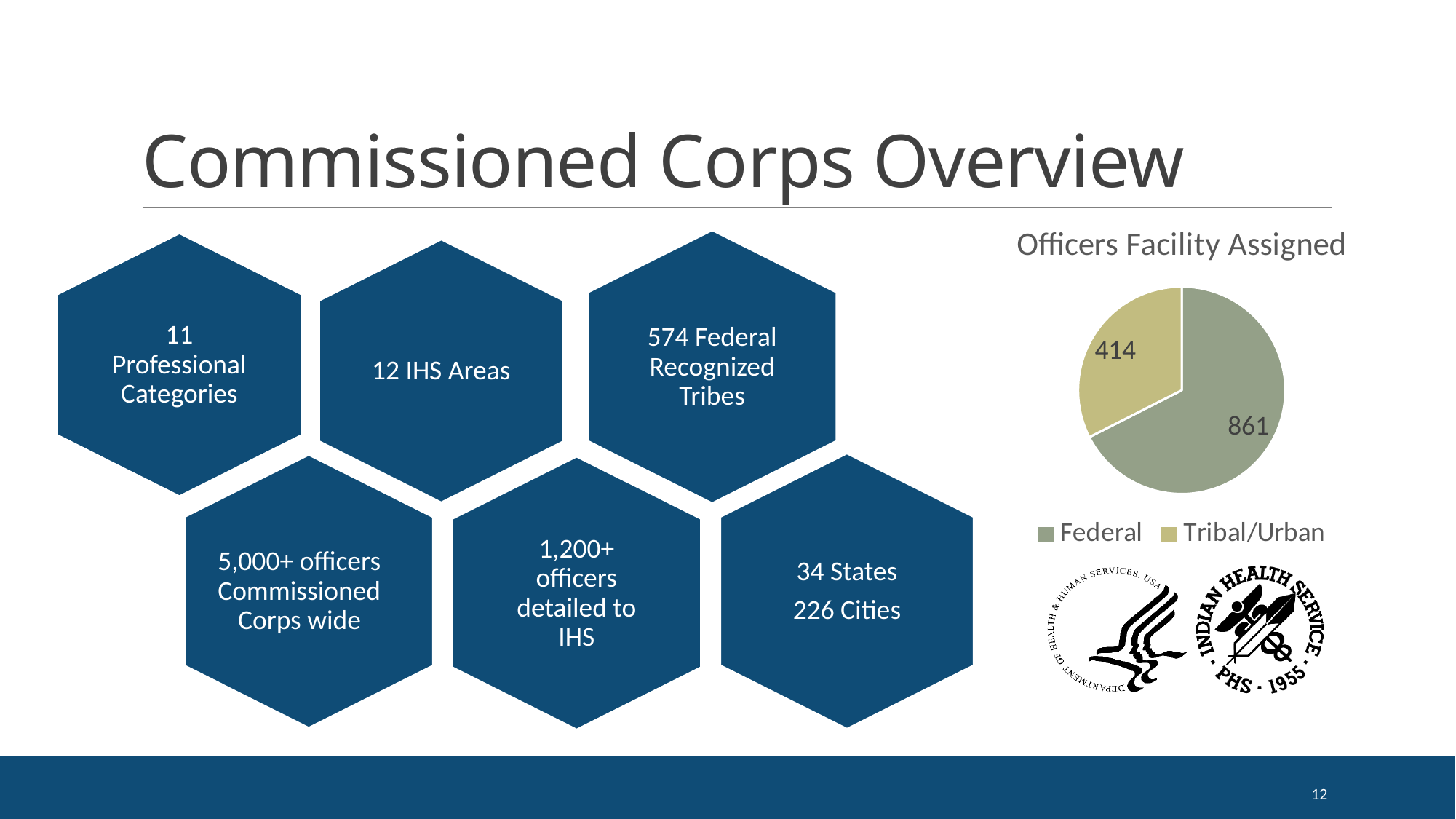
What is the title of the pie chart on the slide? Officers Facility Assigned In the Officers Facility Assigned chart, how many officers are assigned to Federal facilities? 861 In the Officers Facility Assigned chart, what is the difference between the Federal and Tribal/Urban values? 447 What kind of chart is shown under the title "Officers Facility Assigned"? pie chart What is the total of the two values shown in the Officers Facility Assigned pie chart? 1275 Which slice of the Officers Facility Assigned pie chart is the largest? Federal Which slice of the Officers Facility Assigned pie chart is the smallest? Tribal/Urban In the Officers Facility Assigned chart, is the Federal value larger or smaller than the Tribal/Urban value? larger How many entries does the legend of the Officers Facility Assigned chart list? 2 How many slices does the Officers Facility Assigned pie chart have? 2 In the Officers Facility Assigned chart, how many officers are assigned to Tribal/Urban facilities? 414 Which legend entry in the Officers Facility Assigned chart is shown in the lighter khaki colour? Tribal/Urban